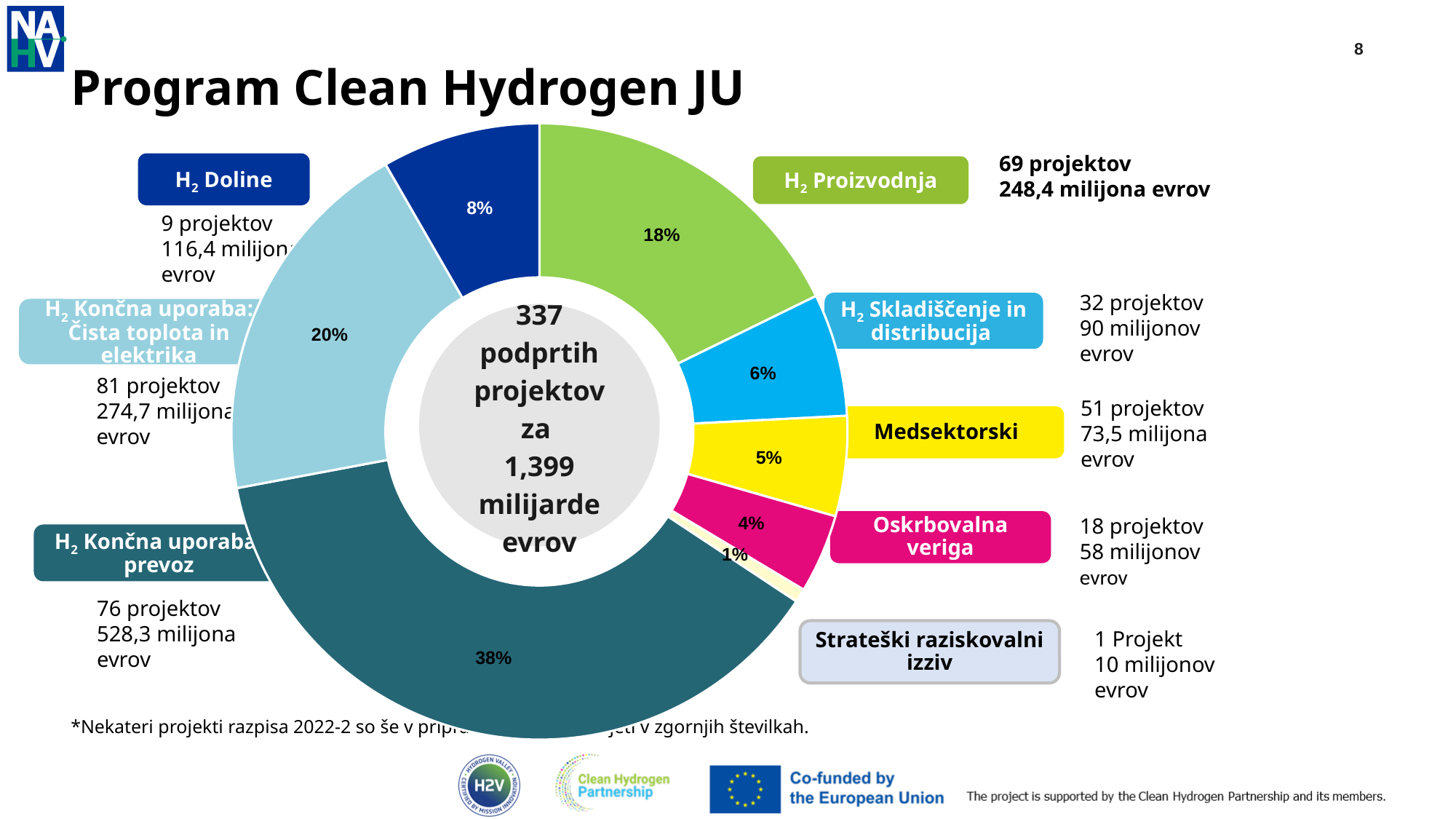
Which segment has the largest share of the chart? H2 Končna uporaba: prevoz What percentage is shown for the Medsektorski segment? 5% What percentage is shown for the H2 Proizvodnja segment? 18% What text is shown in the centre of the doughnut chart? 337 podprtih projektov za 1,399 milijarde evrov Which segment is larger, Oskrbovalna veriga or H2 Skladiščenje in distribucija? H2 Skladiščenje in distribucija What colour is the H2 Končna uporaba: prevoz segment? Dark teal What percentage is shown for the H2 Doline segment? 8% Which segment has the smallest share of the chart? Strateški raziskovalni izziv What is the difference in percentage points between the H2 Končna uporaba: Čista toplota in elektrika segment and the H2 Skladiščenje in distribucija segment? 14 percentage points How many segments does the chart have? 8 What share of the chart does the H2 Končna uporaba: prevoz segment represent? 38% What kind of chart is shown on the slide? Doughnut (pie) chart